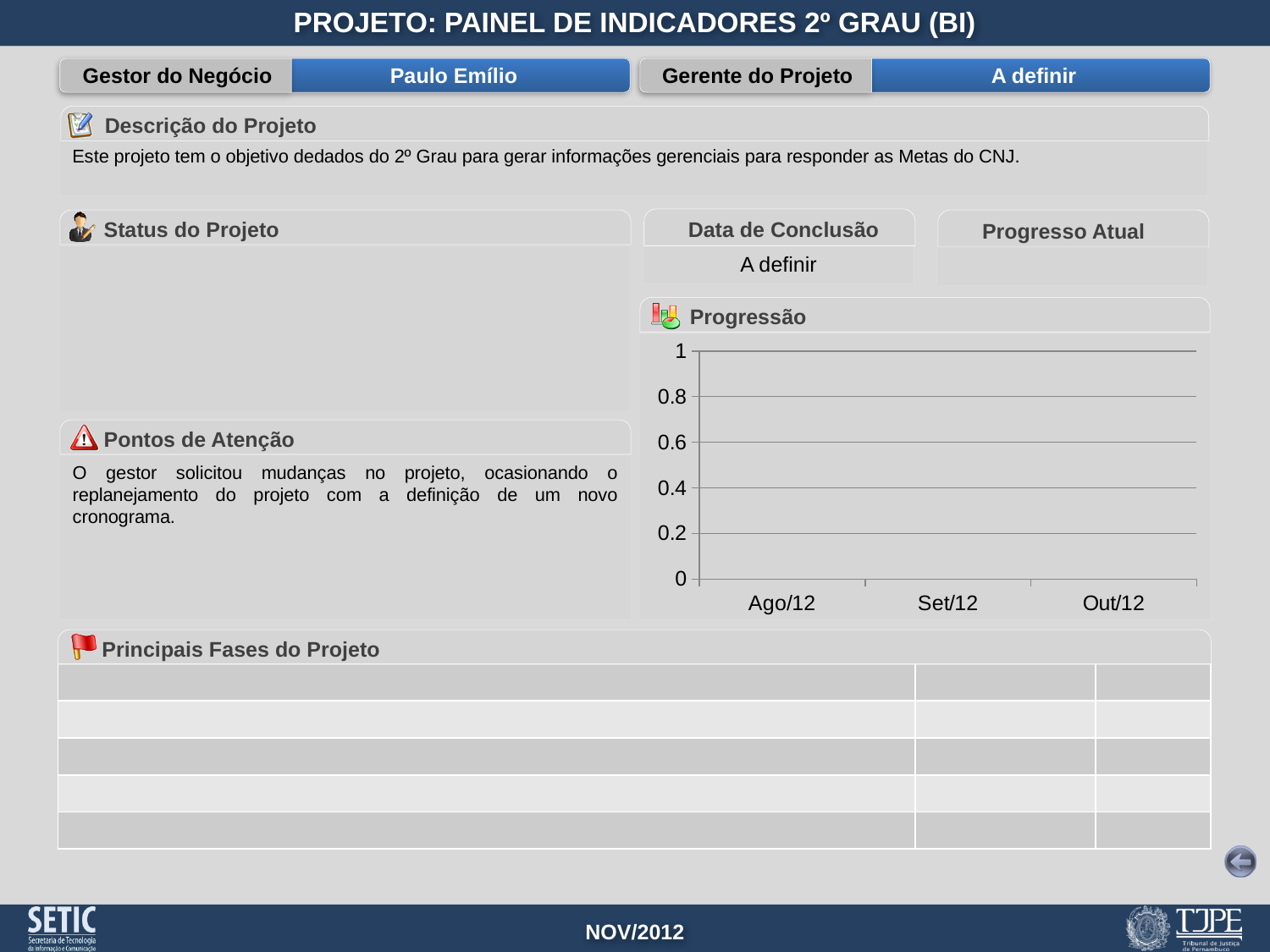
What is the lowest tick value shown on the y axis of the Progressão chart? 0 What is the highest tick value shown on the y axis of the Progressão chart? 1 What is the first category label on the x axis of the Progressão chart? Ago/12 What is the title of the chart on the slide? Progressão How many categories are shown on the x axis of the Progressão chart? 3